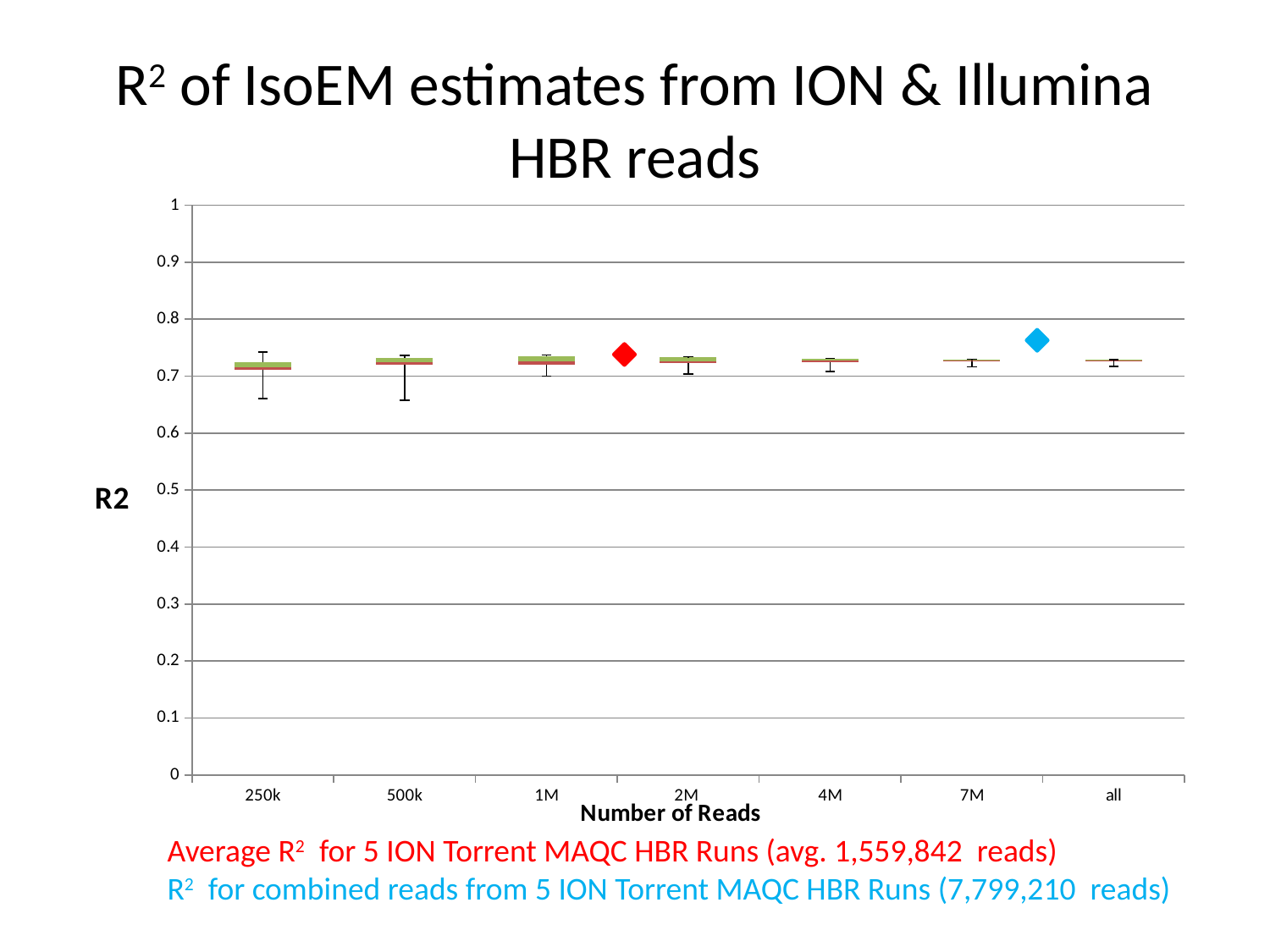
Which diamond marker is plotted higher on the chart, the red one or the blue one? the blue one What is the highest tick value shown on the y axis? 1 What is the label of the x axis? Number of Reads What is the title of the chart? R2 of IsoEM estimates from ION & Illumina HBR reads Is the median R2 value for 250k reads greater or less than 0.6? greater Is the median R2 value for 4M reads greater or less than 0.8? less Is the lowest whisker value for 500k reads greater or less than 0.5? greater Which x-axis category is the last one on the right? all How many read-count categories are shown along the x axis? 7 What kind of chart is shown on the slide? Box plot (box-and-whisker chart)